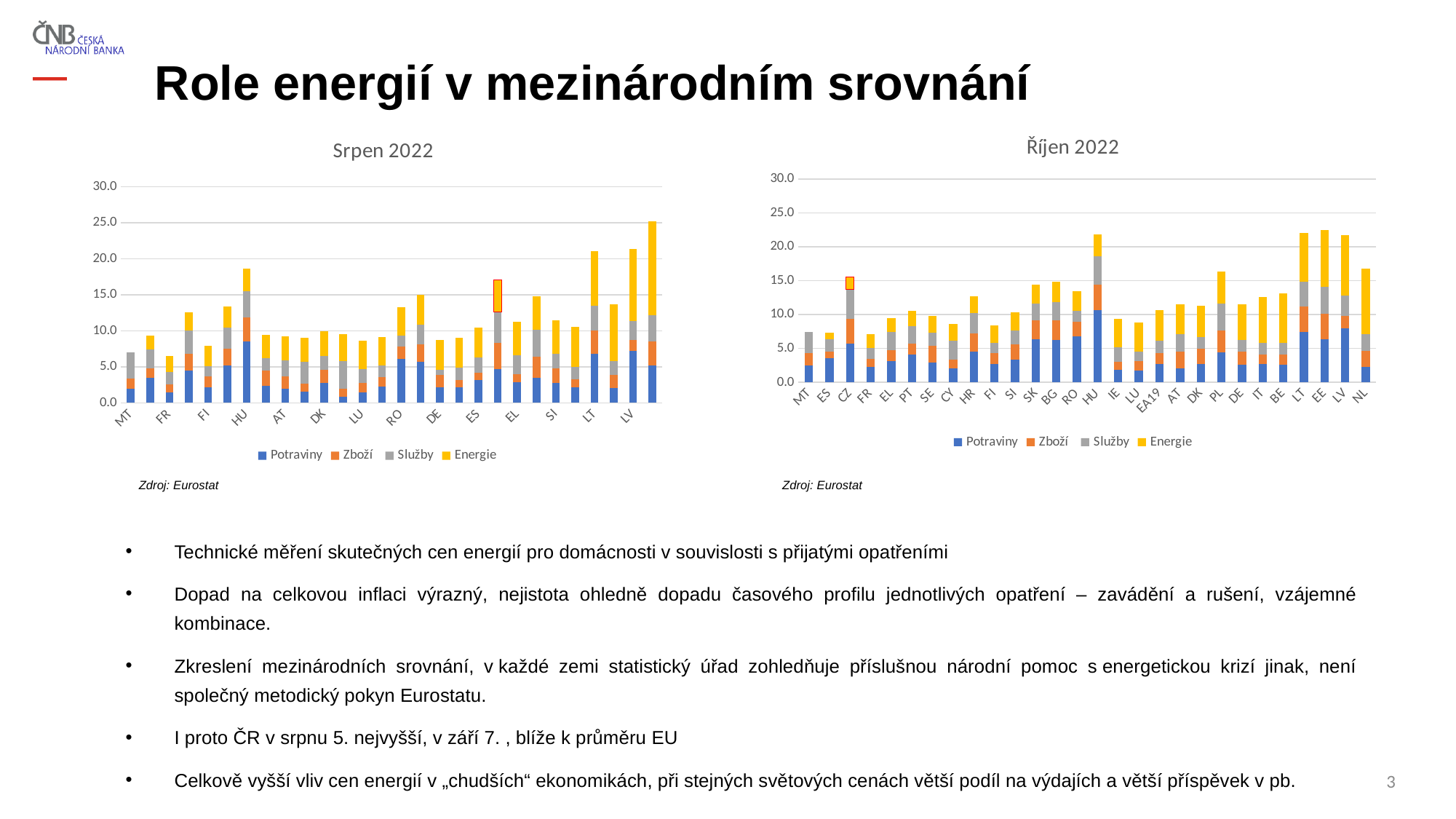
In the 'Srpen 2022' chart, is the total value for FR greater or less than 10? less What is the title of the chart on the left of the slide? Srpen 2022 In the 'Srpen 2022' chart, is the total value for HU greater or less than 15? greater In the 'Srpen 2022' chart, which has the larger total bar, LV or FR? LV In the 'Říjen 2022' chart, which has the larger total bar, HU or MT? HU What kind of chart is the 'Srpen 2022' chart? bar chart In the 'Říjen 2022' chart, is the total value for HU greater or less than 20? greater Which series is shown in yellow in the 'Říjen 2022' chart? Energie How many series does the legend of the 'Říjen 2022' chart list? 4